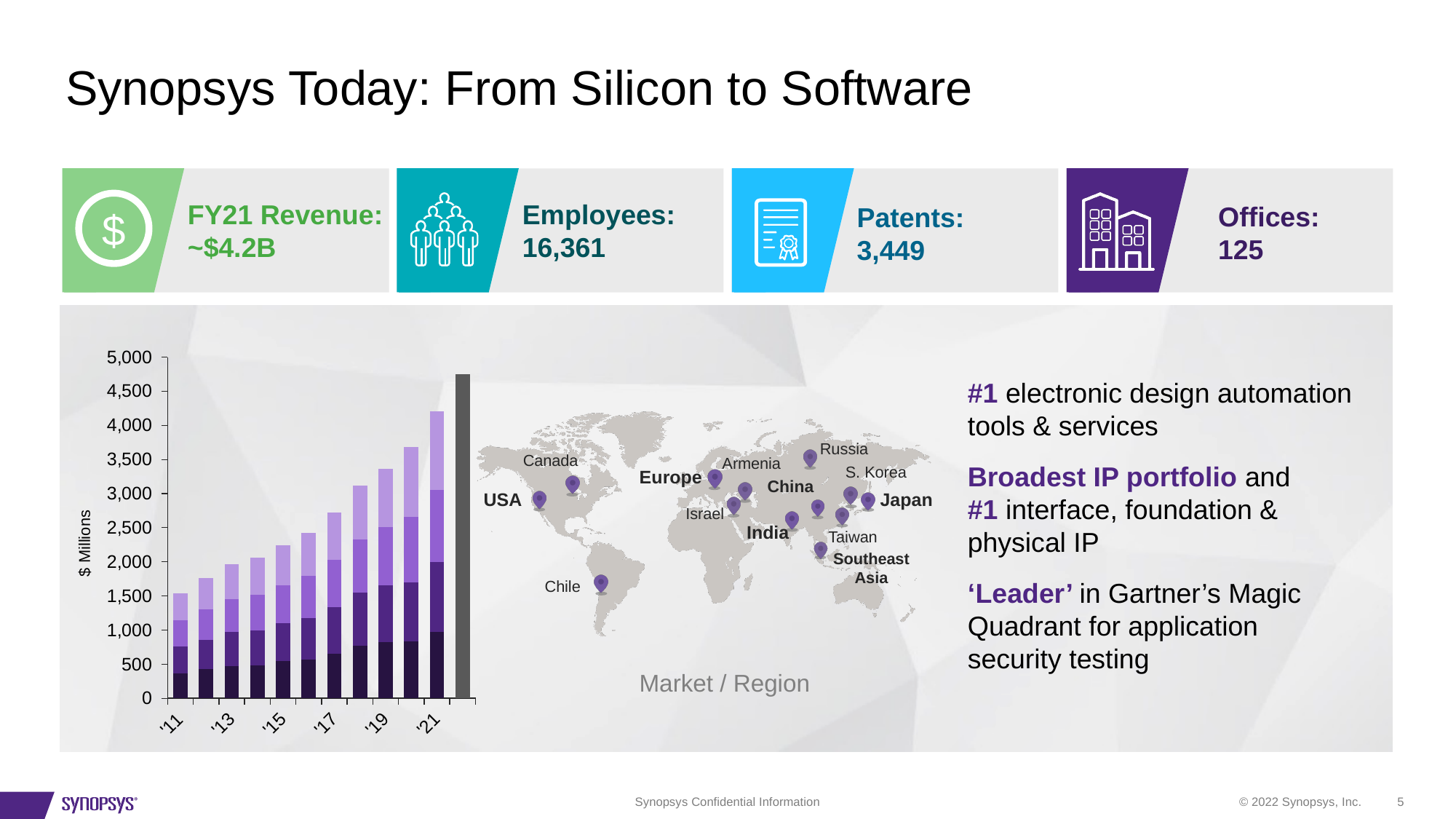
Is the total bar height for '19 greater or less than 3,000? greater Is the bar for '21 taller or shorter than the bar for '17? taller Is the total bar height for '17 greater or less than 2,500? greater How many bars are plotted in the bar chart? 12 Which labeled year has the tallest purple stacked bar in the bar chart? '21 Is the total bar height for '15 greater or less than 2,000? greater What kind of chart is shown on the left of the slide? stacked bar chart In the bar chart, do the bar heights rise or fall from '11 to '21? rise What is the label on the vertical axis of the bar chart? $ Millions Which labeled year has the shortest bar in the bar chart? '11 What is the highest value shown on the vertical axis of the bar chart? 5,000